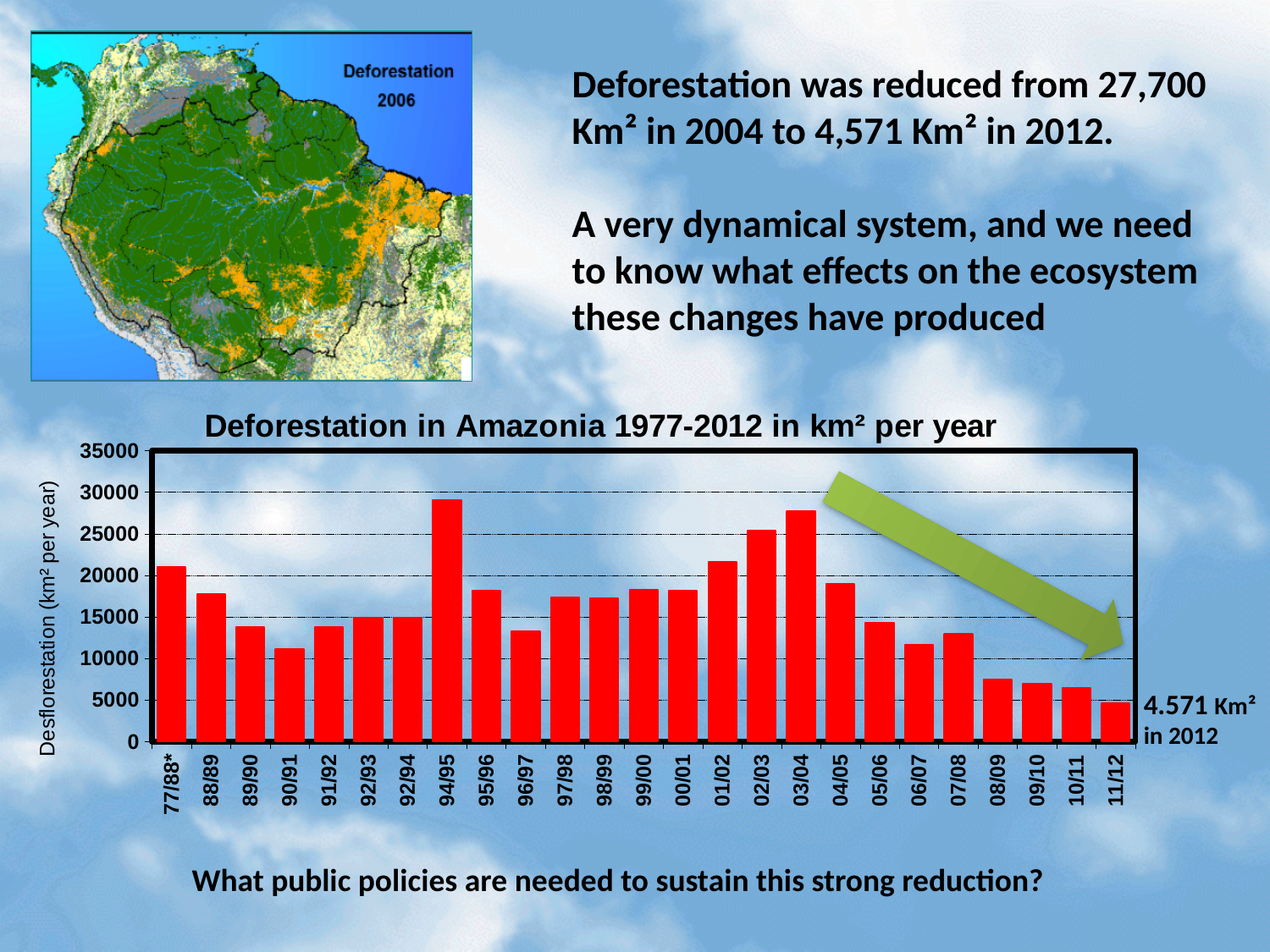
Is the value for 08/09 greater or less than 10000? less How many bars (periods) are plotted in the chart? 25 What is the title of the chart? Deforestation in Amazonia 1977-2012 in km² per year Which period has the lowest deforestation value in the chart? 11/12 What colour are the bars in the chart? red Do the values rise or fall from 03/04 to 11/12? fall Is the value for 03/04 greater or less than 25000? greater What kind of chart is shown on the slide? bar chart Is the value for 06/07 greater or less than 15000? less Which period has the highest deforestation value in the chart? 94/95 What deforestation value is labelled for 2012 (the 11/12 bar)? 4.571 Km² Which is larger, the value for 94/95 or the value for 03/04? 94/95